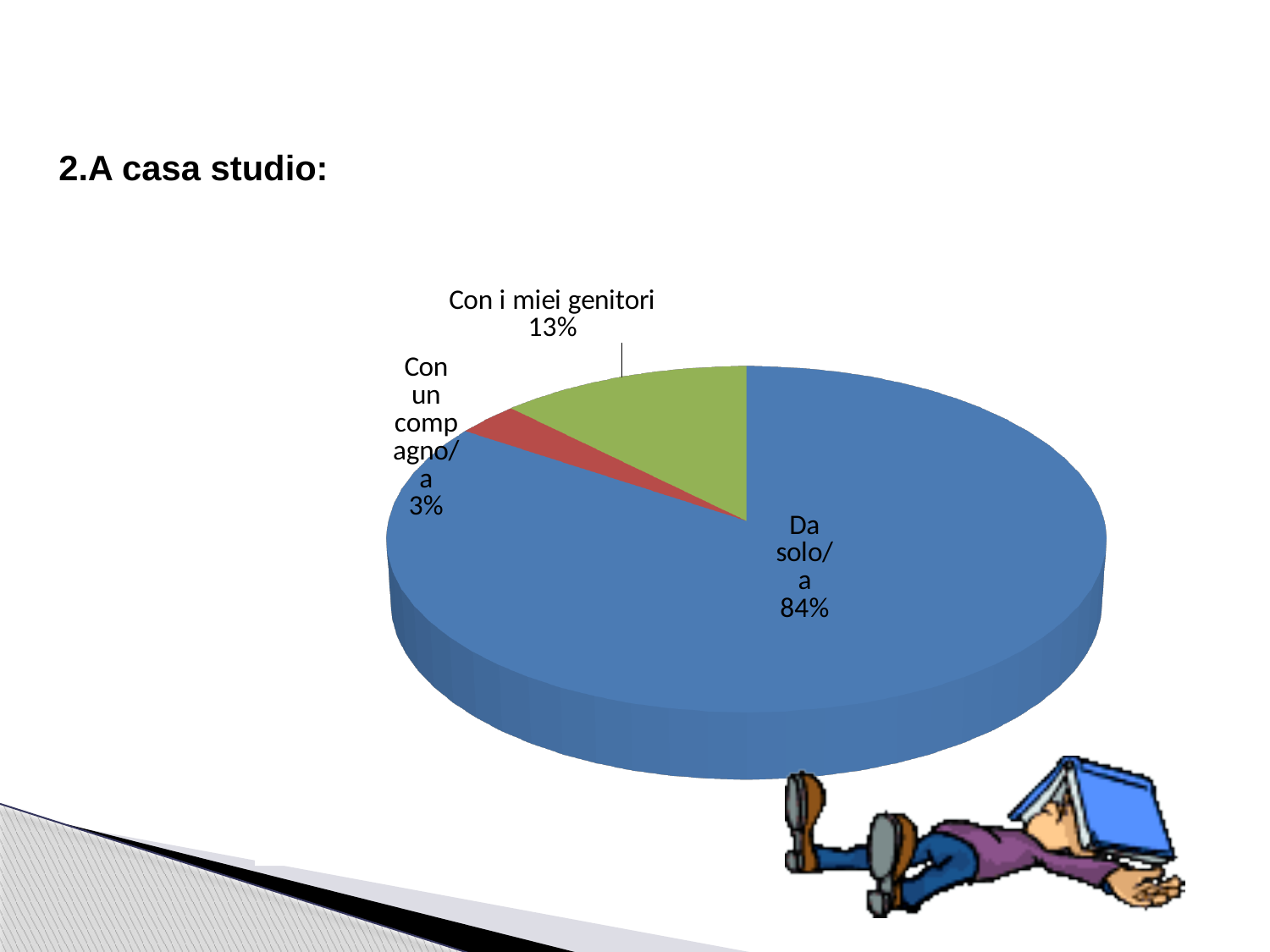
Which is larger, the "Con i miei genitori" slice or the "Con un compagno/a" slice? Con i miei genitori What is the heading text above the chart? 2.A casa studio: What percentage of the pie is labelled "Con i miei genitori"? 13% What is the difference in percentage points between "Con i miei genitori" and "Con un compagno/a"? 10 What is the difference in percentage points between "Da solo/a" and "Con i miei genitori"? 71 How many slices does the pie chart have? 3 Which slice of the pie is the largest? Da solo/a What colour is the "Da solo/a" slice? blue Which slice of the pie is the smallest? Con un compagno/a What percentage of the pie is labelled "Da solo/a"? 84% What percentage of the pie is labelled "Con un compagno/a"? 3% What kind of chart is shown on the slide? pie chart